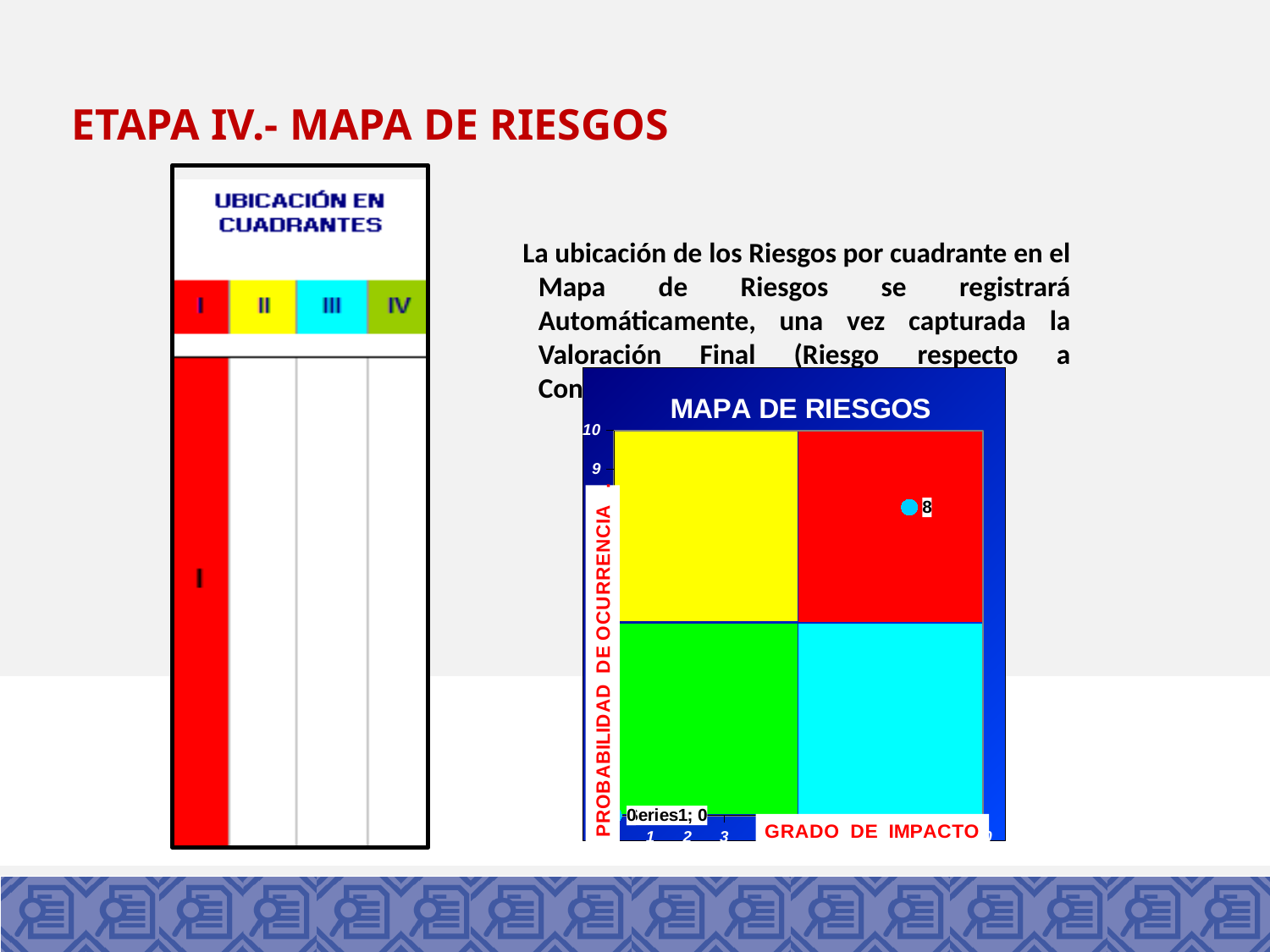
What is the highest tick value shown on the vertical axis of the MAPA DE RIESGOS chart? 10 What is the title of the chart on the right side of the slide? MAPA DE RIESGOS What kind of chart is the MAPA DE RIESGOS chart? scatter chart In the MAPA DE RIESGOS chart, is the horizontal-axis value of the plotted point in the red quadrant greater or less than 3? greater What is the title of the vertical axis of the MAPA DE RIESGOS chart? PROBABILIDAD DE OCURRENCIA In the MAPA DE RIESGOS chart, is the vertical-axis value of the plotted point in the red quadrant greater or less than 9? less In the MAPA DE RIESGOS chart, what is the data label shown next to the plotted point in the red quadrant? 8